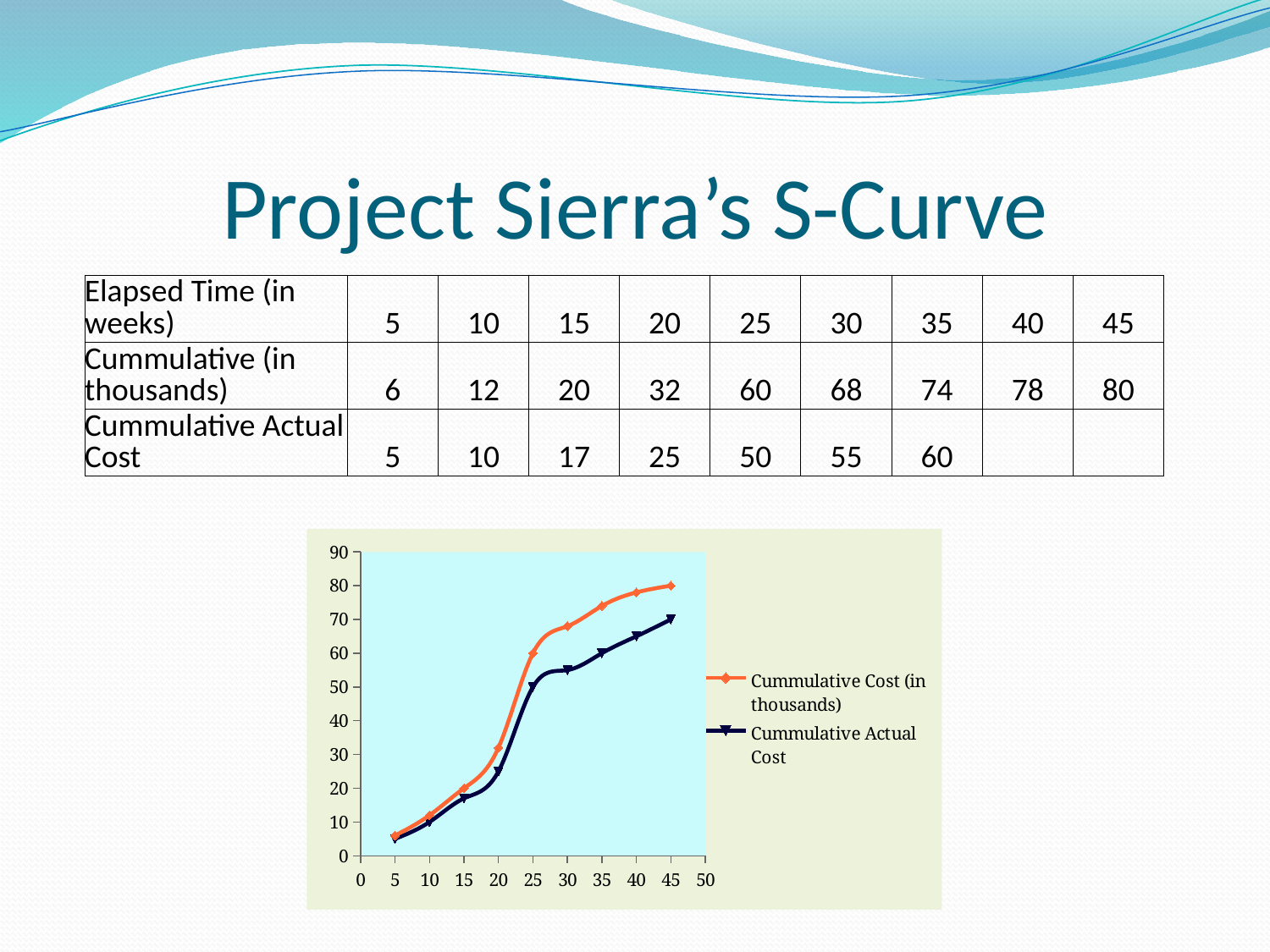
At 20 weeks, which series has the larger value, Cummulative Cost (in thousands) or Cummulative Actual Cost? Cummulative Cost (in thousands) What is the Cummulative Cost (in thousands) at 25 weeks? 60 How many data points are plotted for the Cummulative Cost (in thousands) series? 9 Do the values of the Cummulative Cost (in thousands) series rise or fall as elapsed time increases? rise What is the Cummulative Actual Cost at 30 weeks? 55 At 25 weeks, what is the difference between Cummulative Cost (in thousands) and Cummulative Actual Cost? 10 Is the Cummulative Cost (in thousands) at 35 weeks greater or less than 70? greater Is the value of the Cummulative Actual Cost series at 45 weeks greater or less than 60? greater What is the highest value reached by the Cummulative Cost (in thousands) series? 80 How many series does the chart's legend list? 2 What are the two series named in the chart's legend? Cummulative Cost (in thousands) and Cummulative Actual Cost What kind of chart is shown on the slide? line chart